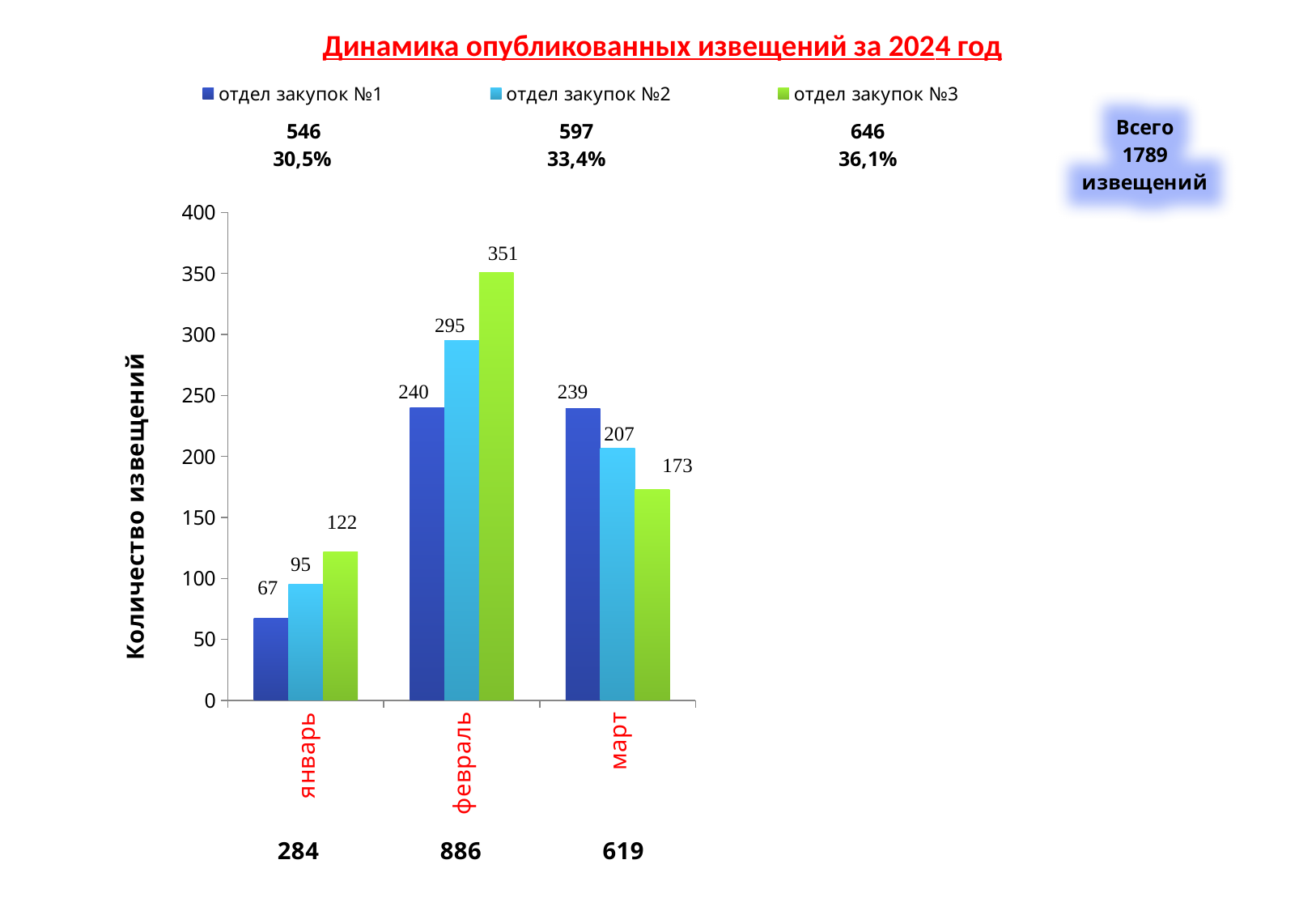
What is the total number of notices shown for февраль? 886 What is the difference between отдел закупок №3 and отдел закупок №1 in февраль? 111 Which is larger in март: отдел закупок №1 or отдел закупок №3? отдел закупок №1 What is the value for отдел закупок №3 in февраль? 351 How many months are shown on the x axis? 3 What is the title of the chart? Динамика опубликованных извещений за 2024 год What is the value for отдел закупок №1 in январь? 67 What kind of chart is shown on the slide? bar chart Which month has the lowest value for отдел закупок №3? январь Which month has the highest value for отдел закупок №2? февраль What is the value for отдел закупок №2 in март? 207 How many series does the legend list? 3